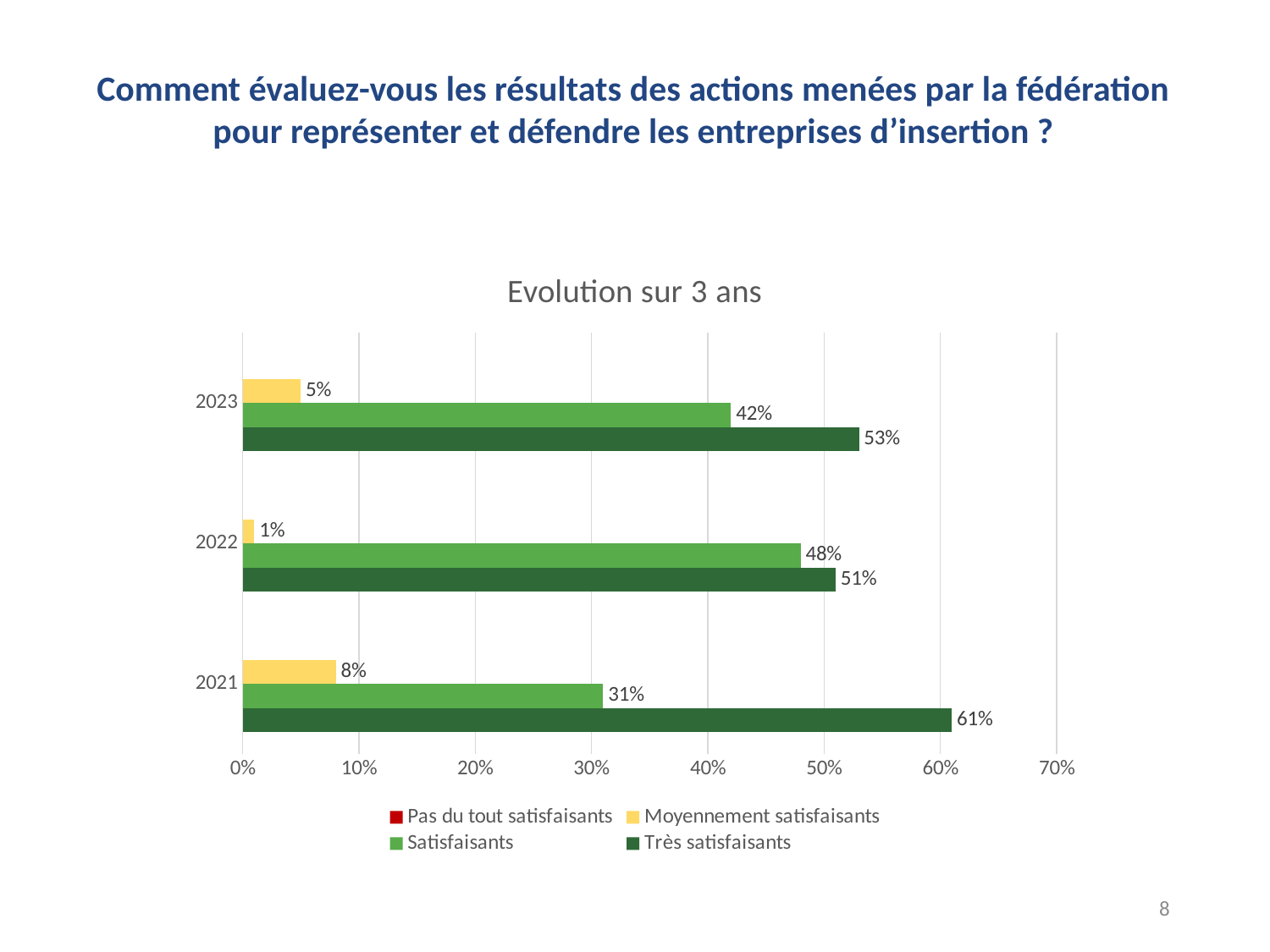
How many years are shown on the chart? 3 Which is larger in 2022: "Satisfaisants" or "Très satisfaisants"? Très satisfaisants What is the difference between the "Très satisfaisants" and "Satisfaisants" values in 2023? 11% In which year is the "Moyennement satisfaisants" value lowest? 2022 What is the value for "Moyennement satisfaisants" in 2023? 5% What is the title of the chart? Evolution sur 3 ans Does the "Satisfaisants" value rise or fall from 2021 to 2022? Rise What is the value for "Satisfaisants" in 2022? 48% How many series does the legend list? 4 In which year is the "Très satisfaisants" value highest? 2021 What kind of chart is shown? Bar chart What is the value for "Très satisfaisants" in 2021? 61%